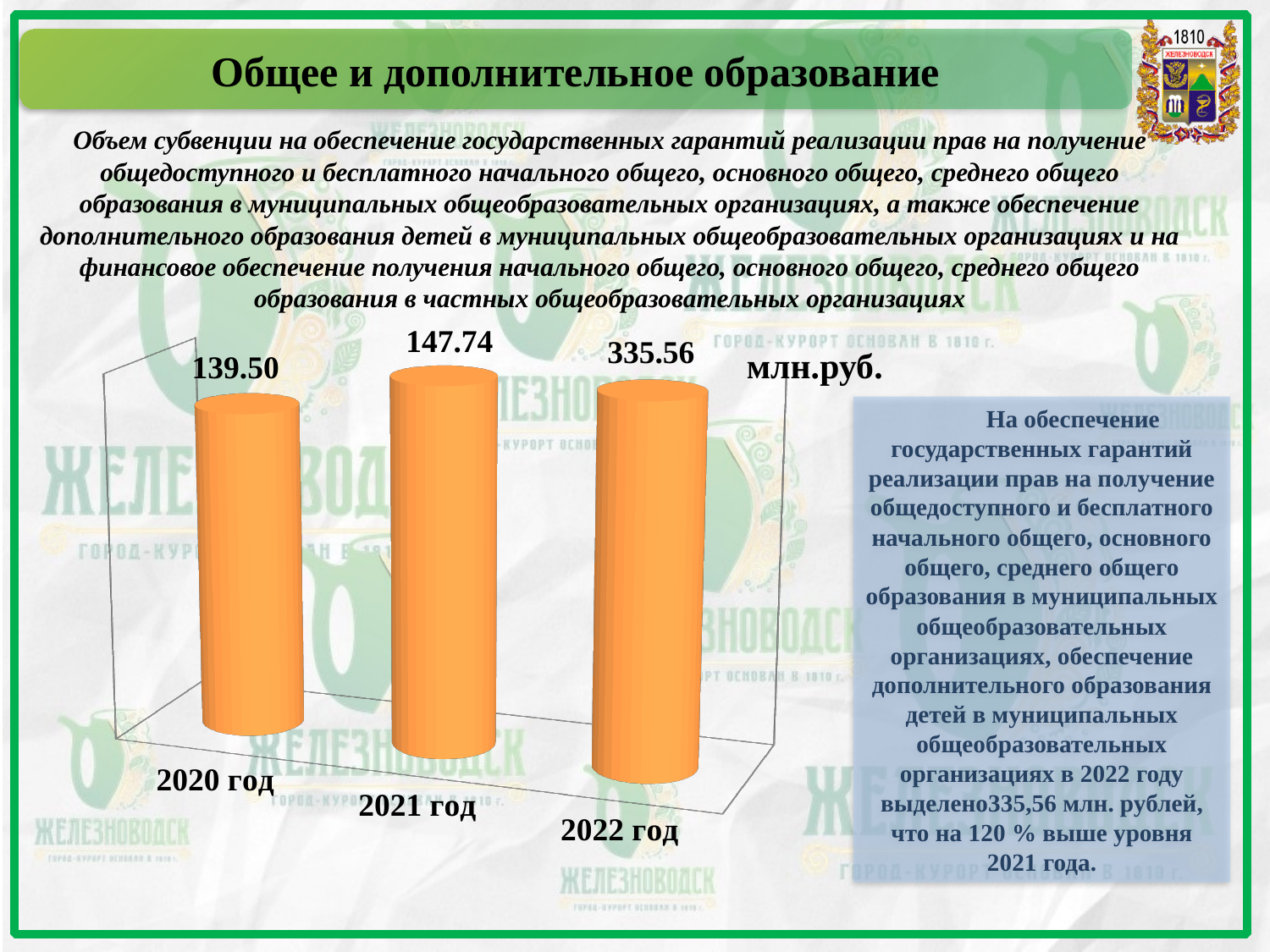
Which year has the highest value according to the data labels? 2022 год Do the labelled values rise or fall from 2020 год to 2022 год? rise What is the value shown for 2021 год? 147.74 Which year has the lowest value according to the data labels? 2020 год What kind of chart is shown on the slide? bar chart How many years (categories) are shown in the chart? 3 What unit is indicated for the values in the chart? млн.руб. What is the difference between the values for 2021 год and 2020 год? 8.24 What is the value shown for 2022 год? 335.56 What is the value shown for 2020 год? 139.50 What is the difference between the values for 2022 год and 2021 год? 187.82 Which is larger according to the data labels: the value for 2021 год or for 2020 год? 2021 год